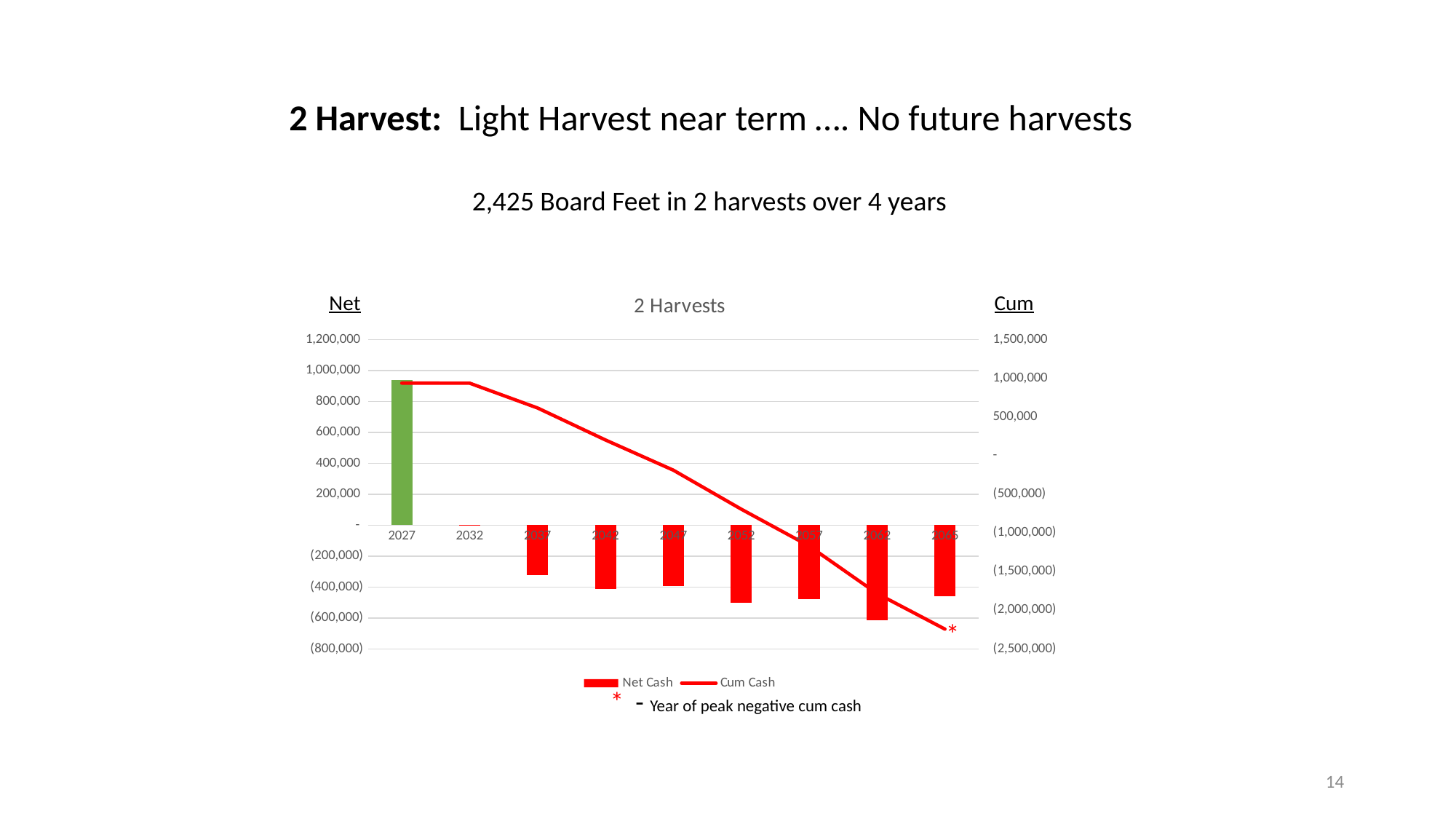
Is the Net Cash value for 2027 greater or less than 800,000? greater Is the Cum Cash value at the final year (marked with the asterisk) greater or less than (2,000,000)? less Which is larger, the Net Cash value for 2027 or the Net Cash value for 2032? 2027 How many series does the chart legend list? 2 What is the title of the chart? 2 Harvests Is the Net Cash value for 2027 greater or less than 1,000,000? less Which year has the highest Net Cash bar? 2027 What are the two series named in the chart legend? Net Cash and Cum Cash According to the note below the chart, what does the asterisk mark? Year of peak negative cum cash What kind of chart is shown on the slide? A combination bar and line chart How many years are plotted along the x axis of the chart? 9 Does the Cum Cash line rise or fall from 2032 onward along the x axis? fall